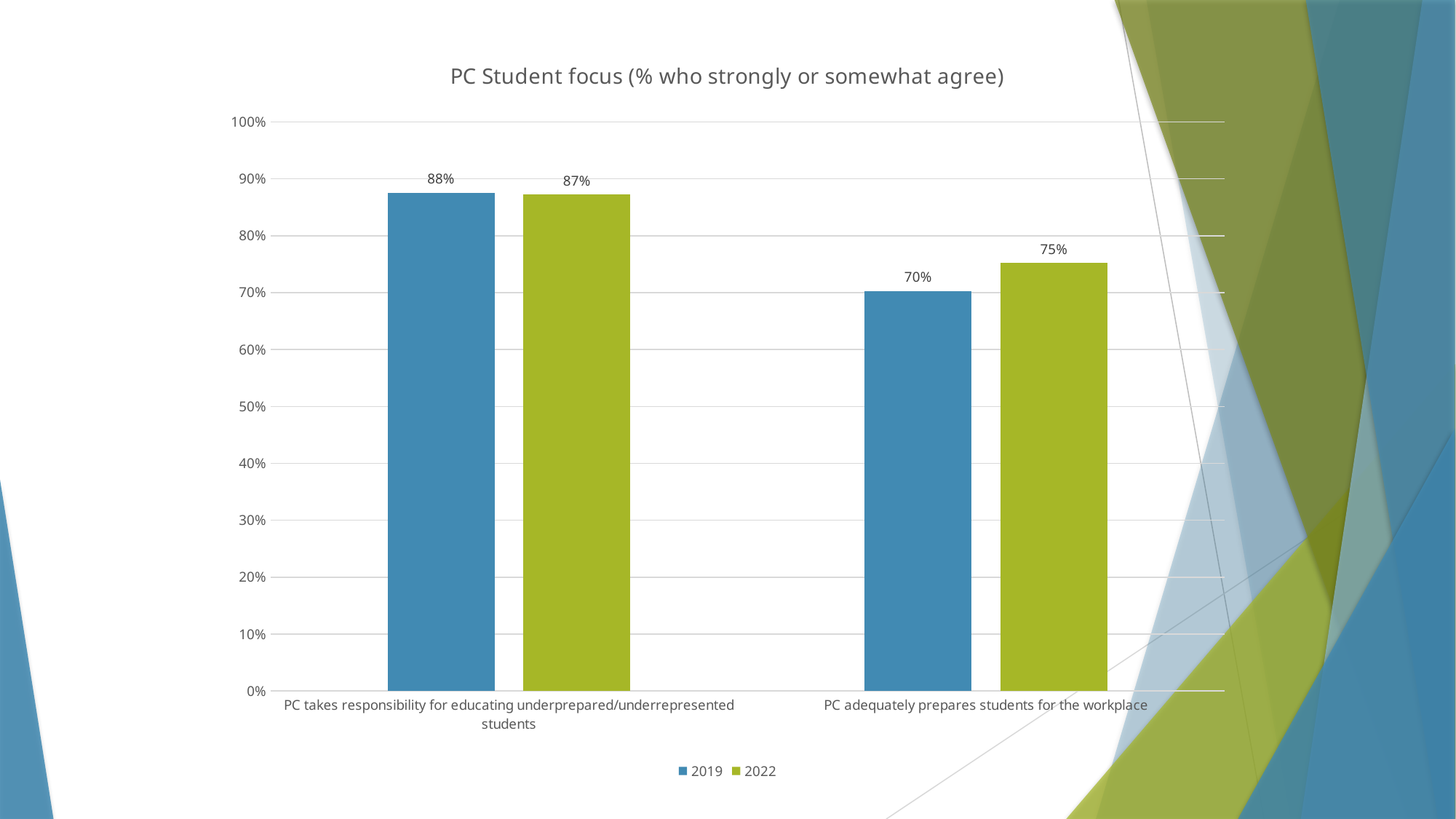
How many categories are shown on the x axis? 2 What is the title of the chart? PC Student focus (% who strongly or somewhat agree) What is the 2022 value for "PC adequately prepares students for the workplace"? 75% What is the difference between the 2022 and 2019 values for "PC adequately prepares students for the workplace"? 5% What kind of chart is shown on the slide? Bar chart Which category has the highest 2019 value? PC takes responsibility for educating underprepared/underrepresented students What is the 2019 value for "PC takes responsibility for educating underprepared/underrepresented students"? 88% How many series does the legend list? 2 What is the 2019 value for "PC adequately prepares students for the workplace"? 70% For "PC adequately prepares students for the workplace", which year has the larger value, 2019 or 2022? 2022 What is the 2022 value for "PC takes responsibility for educating underprepared/underrepresented students"? 87% Which category has the lowest 2022 value? PC adequately prepares students for the workplace